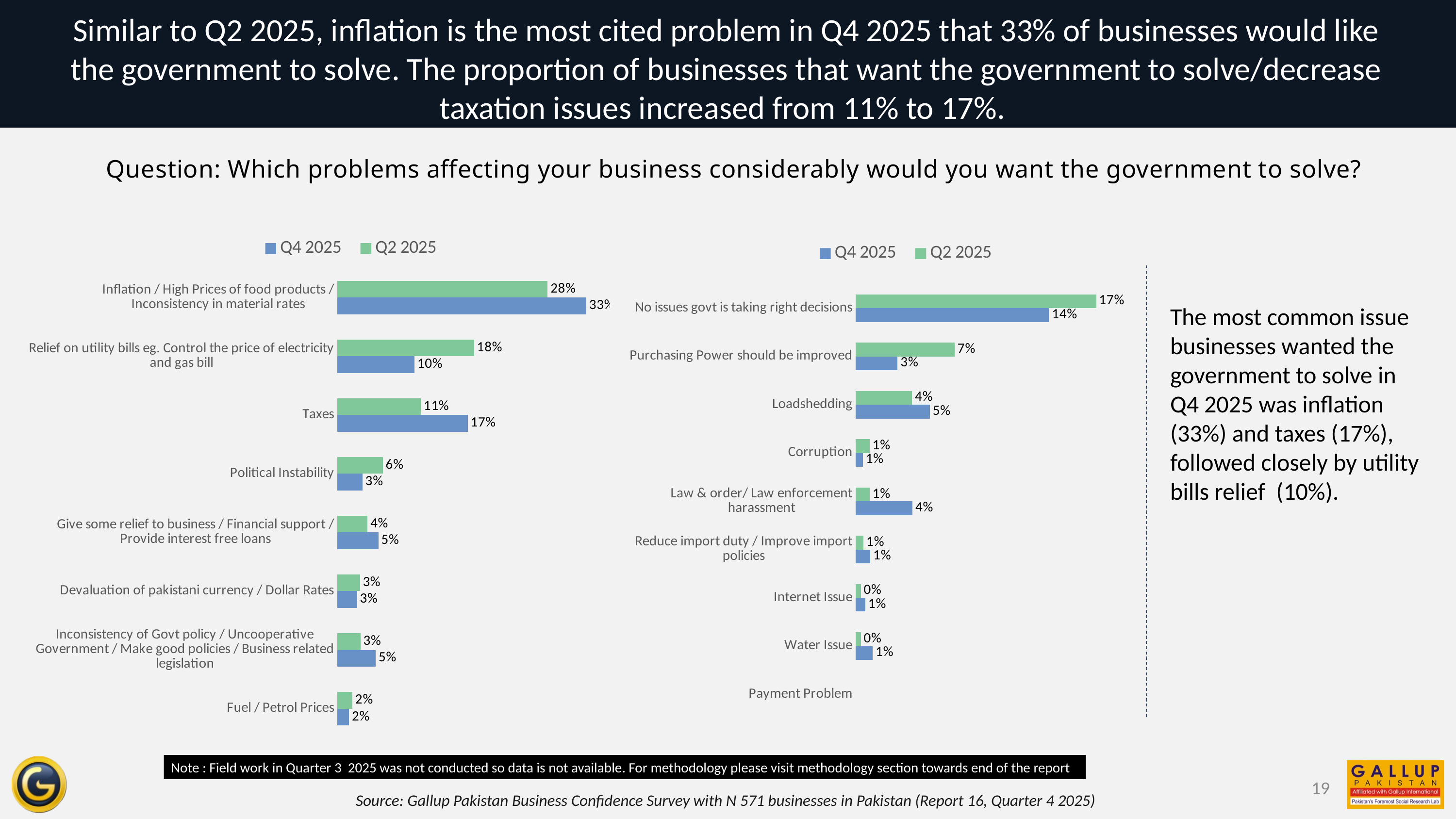
In the left chart, which is larger for Political Instability: the Q4 2025 value or the Q2 2025 value? Q2 2025 How many series does the legend of the left chart list? 2 In the left chart, what is the Q2 2025 value for Relief on utility bills eg. Control the price of electricity and gas bill? 18% How many categories are listed on the right chart? 9 In the right chart, what is the Q2 2025 value for Purchasing Power should be improved? 7% What kind of chart is the left chart? Bar chart In the left chart, what is the Q4 2025 value for Taxes? 17% In the left chart, what is the difference between the Q4 2025 and Q2 2025 values for Inflation / High Prices of food products / Inconsistency in material rates? 5% In the left chart, which category has the highest Q4 2025 value? Inflation / High Prices of food products / Inconsistency in material rates In the right chart, which category has the highest Q2 2025 value? No issues govt is taking right decisions In the right chart, what is the Q4 2025 value for No issues govt is taking right decisions? 14% In the right chart, what is the difference between the Q4 2025 and Q2 2025 values for Law & order/ Law enforcement harassment? 3%